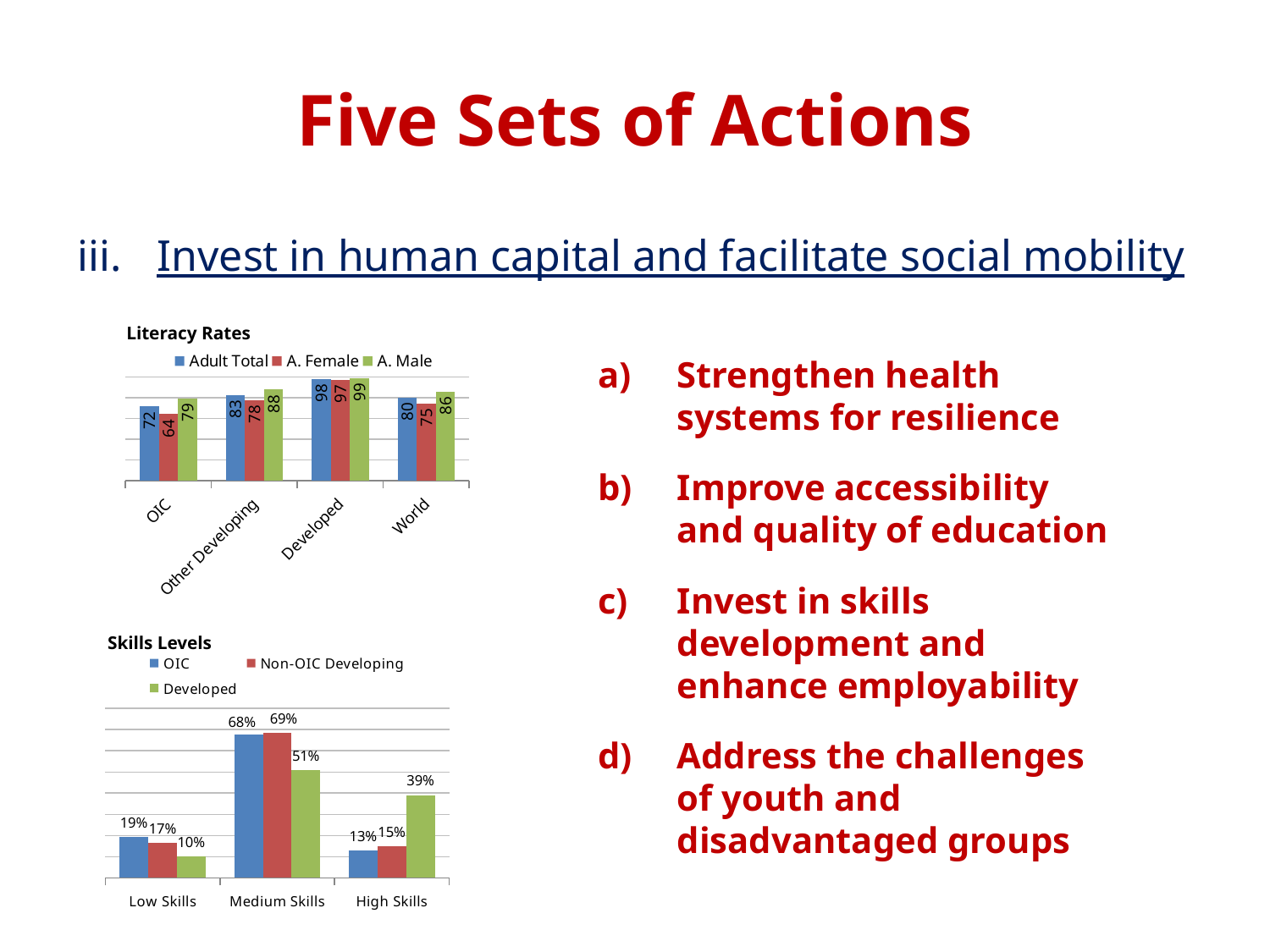
In the Literacy Rates chart, which category has the highest A. Male value? Developed In the Literacy Rates chart, which category has the lowest A. Female value? OIC In the Skills Levels chart, what is the Developed value for High Skills? 39% In the Skills Levels chart, what is the difference between the Non-OIC Developing and Developed values for Medium Skills? 18% In the Skills Levels chart, what is the OIC value for Medium Skills? 68% In the Literacy Rates chart, what is the Adult Total literacy rate for OIC? 72 In the Literacy Rates chart, what is the A. Female value for Developed? 97 What kind of chart is the Skills Levels chart? Bar chart In the Literacy Rates chart, how many series does the legend list? 3 In the Skills Levels chart, which is larger for Low Skills: OIC or Developed? OIC In the Literacy Rates chart, what is the difference between the A. Male and A. Female values for OIC? 15 In the Literacy Rates chart, how many categories are shown on the x axis? 4